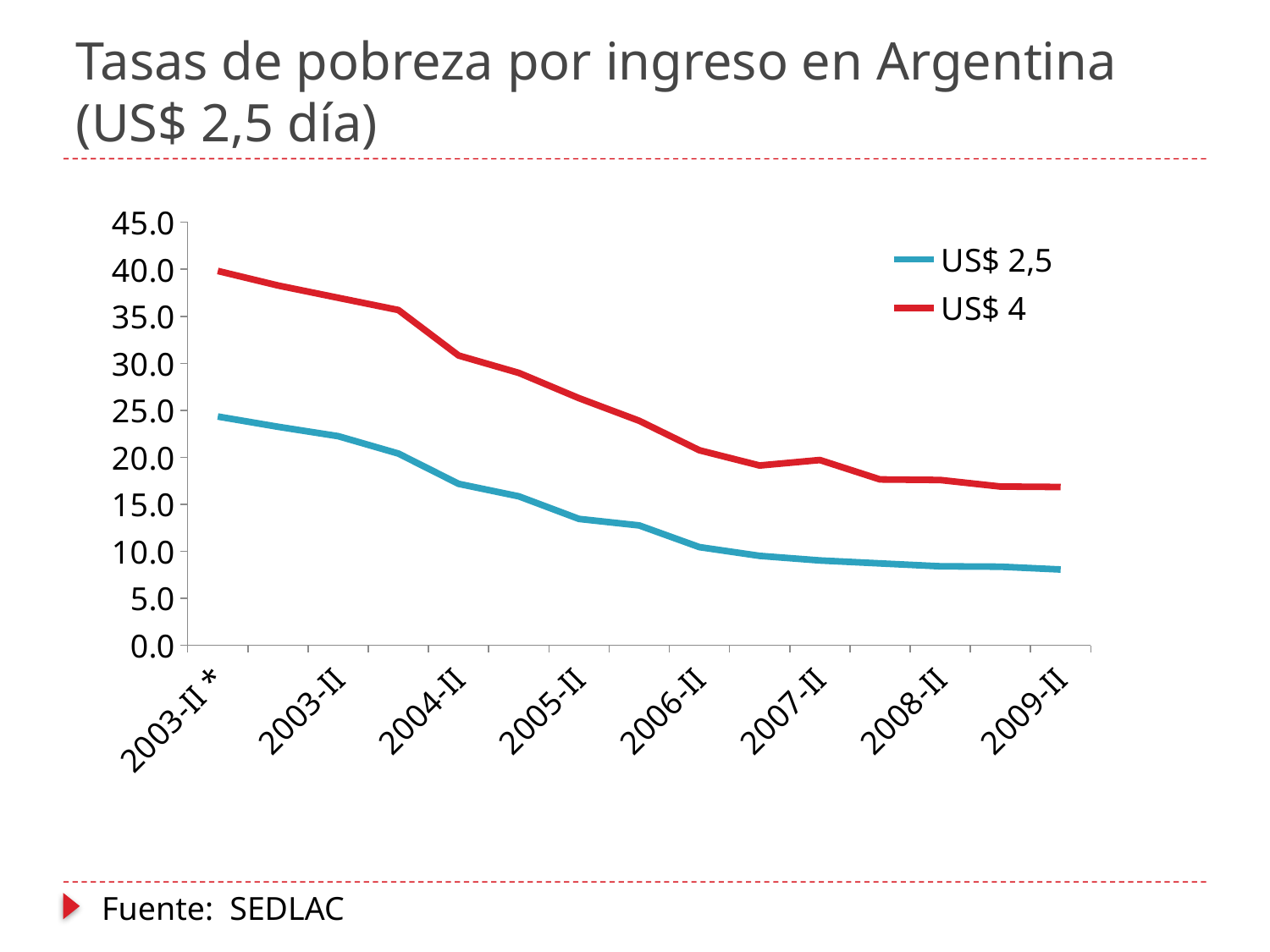
Is the value for US$ 4 at 2003-II * greater or less than 35.0? greater Is the value for US$ 2,5 at 2009-II greater or less than 10.0? less Do the values of the US$ 4 series rise or fall from 2003-II * to 2009-II? fall At 2009-II, which series has the larger value, US$ 2,5 or US$ 4? US$ 4 What kind of chart is shown on the slide? line chart Is the value for US$ 2,5 at 2003-II * greater or less than 20.0? greater Do the values of the US$ 2,5 series rise or fall from 2003-II * to 2009-II? fall How many series does the legend list? 2 What is the source cited at the bottom of the slide? SEDLAC Which series is plotted in red? US$ 4